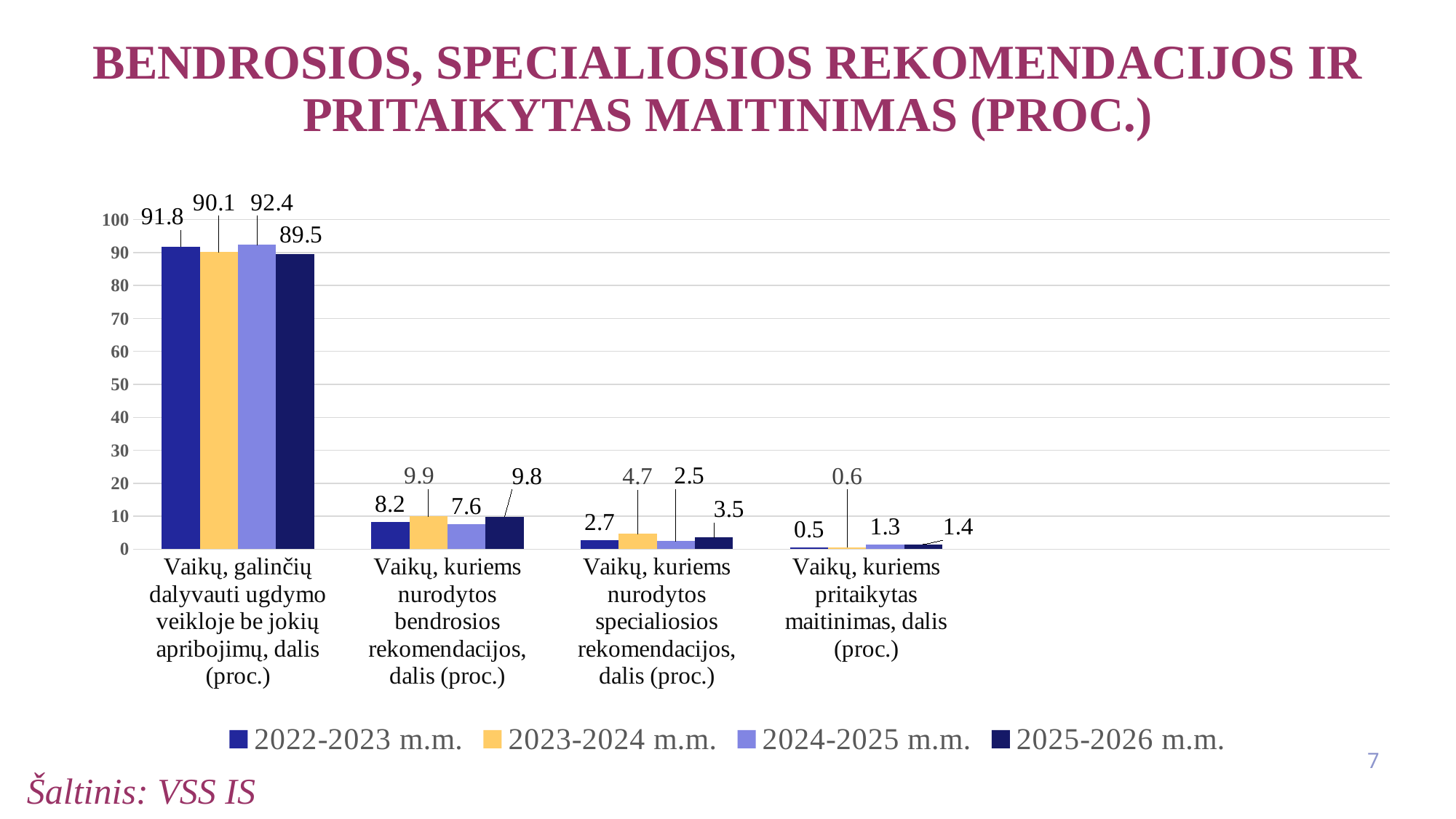
Is the value for 2023-2024 m.m. in the category 'Vaikų, galinčių dalyvauti ugdymo veikloje be jokių apribojimų, dalis (proc.)' greater or less than 80? greater What is the value for 2023-2024 m.m. in the category 'Vaikų, kuriems nurodytos bendrosios rekomendacijos, dalis (proc.)'? 9.9 What is the value for 2025-2026 m.m. in the category 'Vaikų, kuriems pritaikytas maitinimas, dalis (proc.)'? 1.4 Which school year has the highest value in the category 'Vaikų, kuriems nurodytos specialiosios rekomendacijos, dalis (proc.)'? 2023-2024 m.m. What is the value for 2024-2025 m.m. in the category 'Vaikų, galinčių dalyvauti ugdymo veikloje be jokių apribojimų, dalis (proc.)'? 92.4 How many series does the legend list? 4 In the category 'Vaikų, kuriems nurodytos bendrosios rekomendacijos, dalis (proc.)', which is larger: the value for 2022-2023 m.m. or for 2024-2025 m.m.? 2022-2023 m.m. Which school year has the lowest value in the category 'Vaikų, galinčių dalyvauti ugdymo veikloje be jokių apribojimų, dalis (proc.)'? 2025-2026 m.m. What type of chart is shown on the slide? bar chart What is the difference between the 2024-2025 m.m. and 2025-2026 m.m. values in the category 'Vaikų, galinčių dalyvauti ugdymo veikloje be jokių apribojimų, dalis (proc.)'? 2.9 How many categories are shown on the x axis? 4 What is the source cited below the chart? VSS IS